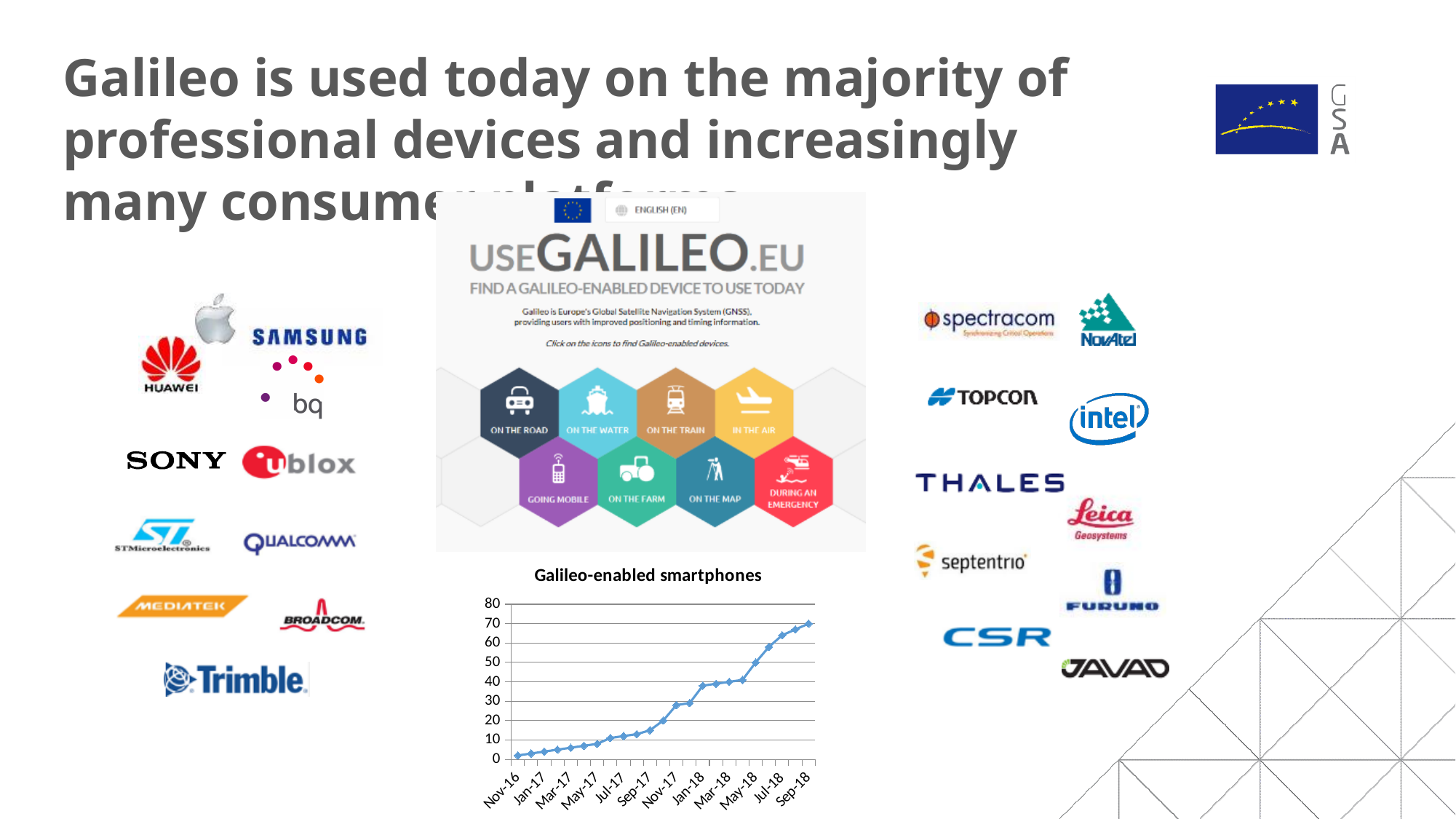
What is the title of the chart at the bottom centre of the slide? Galileo-enabled smartphones What is the highest tick value on the y axis of the 'Galileo-enabled smartphones' chart? 80 In the 'Galileo-enabled smartphones' chart, which labelled month has the highest value? Sep-18 In the 'Galileo-enabled smartphones' chart, is the value for Sep-17 greater or less than 20? less What kind of chart is the 'Galileo-enabled smartphones' chart? line chart In the 'Galileo-enabled smartphones' chart, which labelled month has the lowest value? Nov-16 In the 'Galileo-enabled smartphones' chart, do the values rise or fall from Nov-16 to Sep-18? rise In the 'Galileo-enabled smartphones' chart, which is larger, the value for Sep-18 or the value for Nov-16? Sep-18 In the 'Galileo-enabled smartphones' chart, is the value for Nov-16 greater or less than 10? less In the 'Galileo-enabled smartphones' chart, is the value for Jul-18 greater or less than 50? greater How many month labels are shown on the x axis of the 'Galileo-enabled smartphones' chart? 12